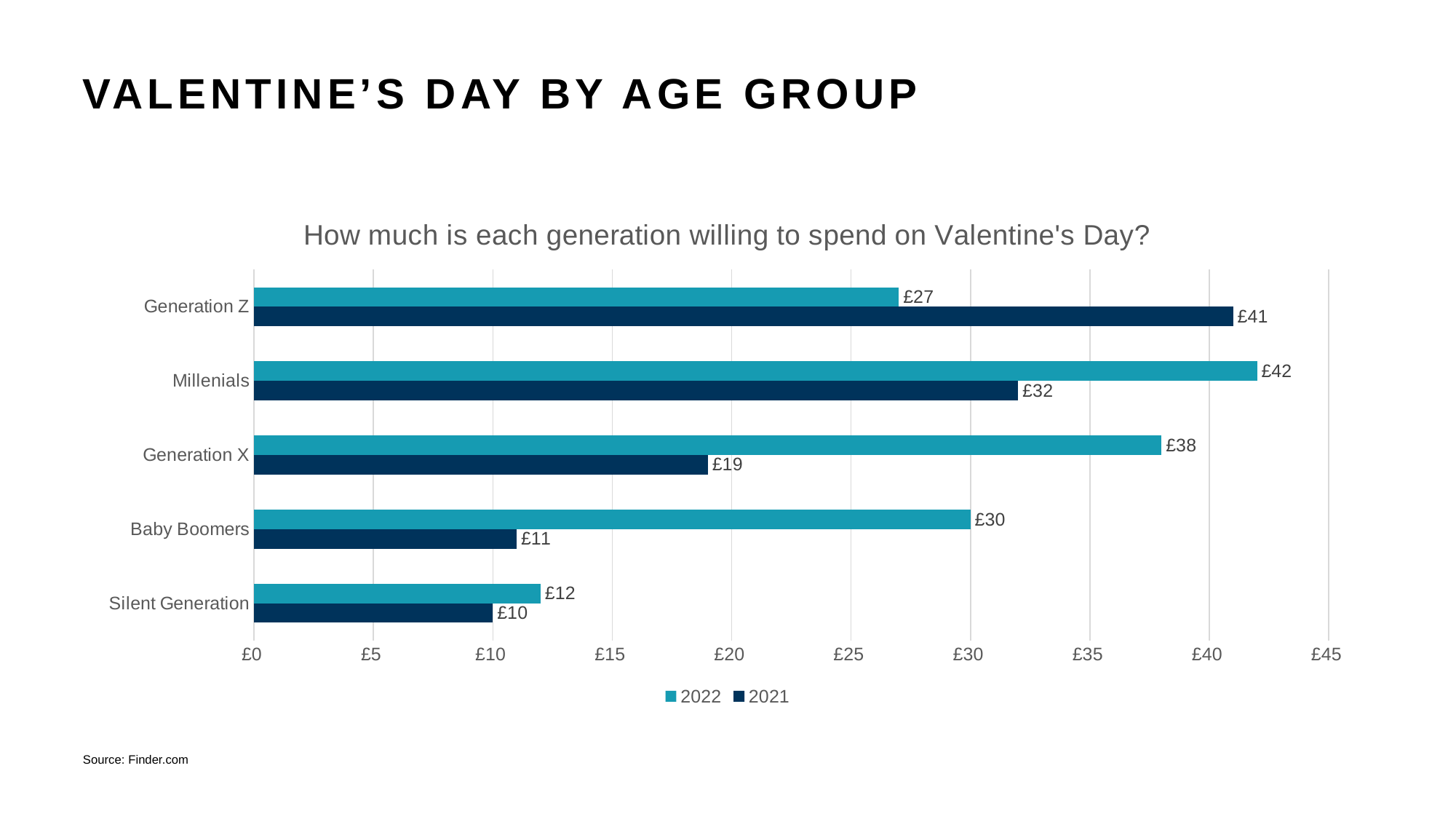
What is the title of the chart? How much is each generation willing to spend on Valentine's Day? What is the difference between the 2021 values for Generation Z and Millenials? £9 What is the 2021 value for Baby Boomers? £11 How many series does the legend list? 2 What is the difference between the 2022 and 2021 values for Baby Boomers? £19 What kind of chart is shown on the slide? Bar chart Which generation has the highest 2021 value? Generation Z Which is larger for Generation Z: the 2022 value or the 2021 value? 2021 What is the 2021 value for Generation X? £19 What is the 2022 value for Millenials? £42 How many generations are shown on the chart? 5 Which generation has the lowest 2022 value? Silent Generation